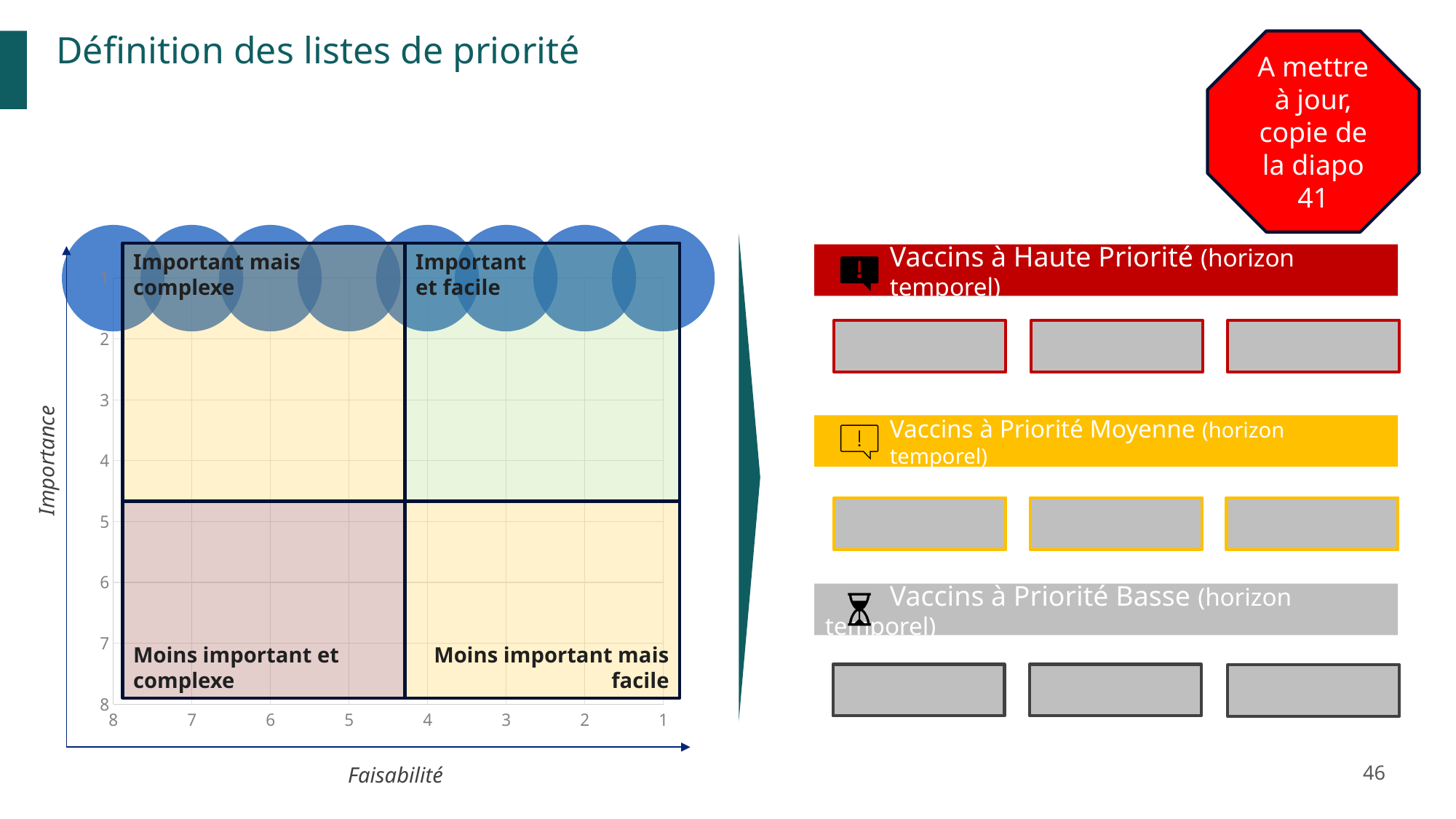
What is the label of the vertical axis of the priority matrix chart? Importance How many tick values are shown on the Faisabilité axis of the priority matrix chart? 8 On the priority matrix chart, is the Importance value of the blue circles greater or less than 4? less How many blue circles are plotted on the priority matrix chart? 8 What is the highest tick value shown on the Importance axis of the priority matrix chart? 8 What is the label of the horizontal axis of the priority matrix chart? Faisabilité On the priority matrix chart, at which Importance tick value are the blue circles positioned? 1 What is the lowest tick value shown on the Faisabilité axis of the priority matrix chart? 1 How many quadrants does the priority matrix chart contain? 4